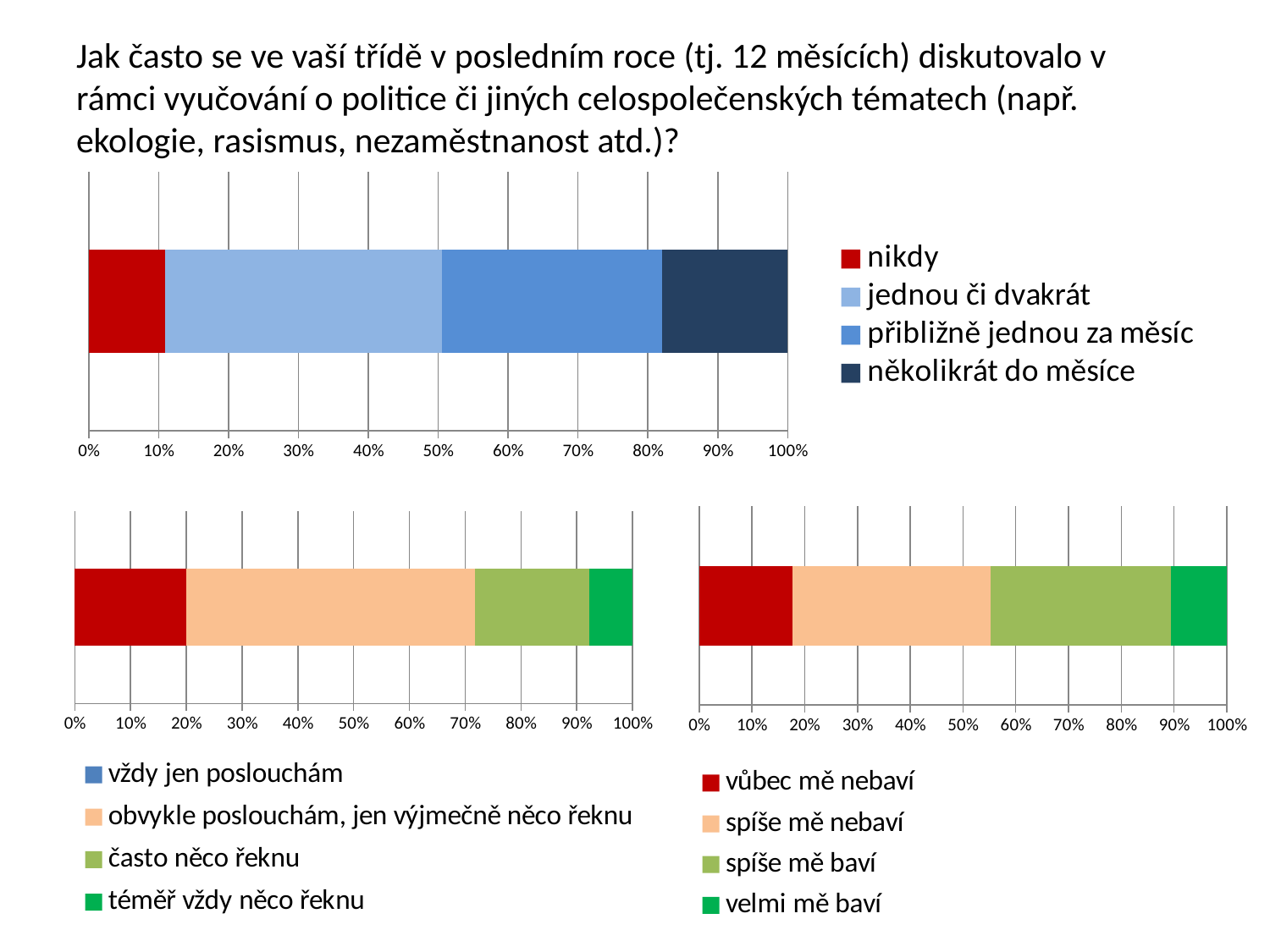
In the top chart, which segment is larger: 'přibližně jednou za měsíc' or 'několikrát do měsíce'? přibližně jednou za měsíc In the top chart, which series has the largest segment? jednou či dvakrát In the top chart, is the share for 'nikdy' greater or less than 20%? less In the bottom-left chart, which series has the smallest segment? téměř vždy něco řeknu In the bottom-left chart, is the share for 'téměř vždy něco řeknu' greater or less than 10%? less In the bottom-left chart, which series has the largest segment? obvykle poslouchám, jen výjmečně něco řeknu In the bottom-right chart, is the share for 'vůbec mě nebaví' greater or less than 10%? greater In the bottom-right chart, which series has the smallest segment? velmi mě baví In the top chart, which series has the smallest segment? nikdy How many series does the legend of the top chart list? 4 What kind of chart is the top chart on the slide? bar chart In the bottom-right chart, what colour represents 'velmi mě baví'? green